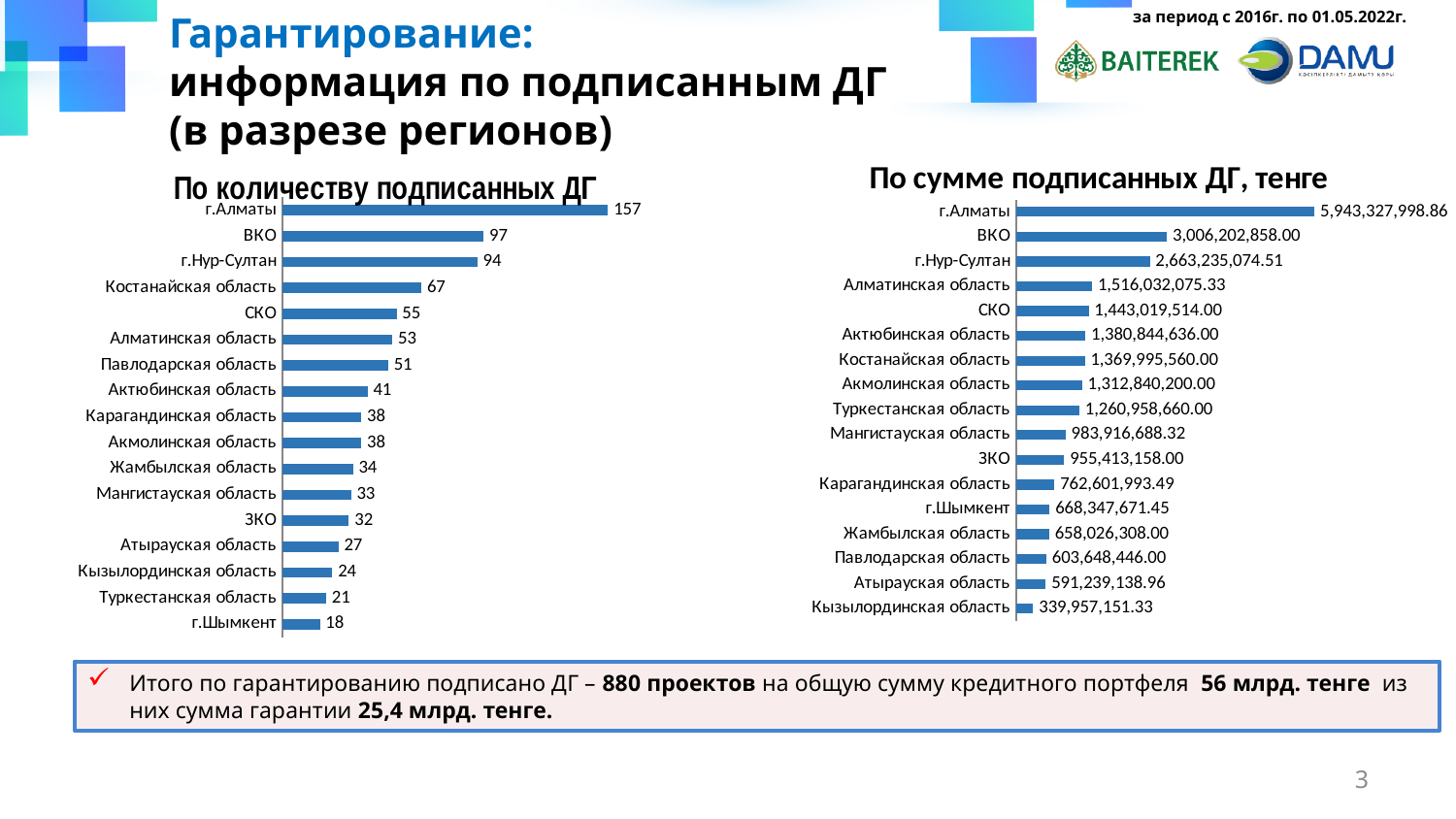
In the chart 'По количеству подписанных ДГ', what is the value for г.Алматы? 157 In the chart 'По количеству подписанных ДГ', which category has the lowest value? г.Шымкент In the chart 'По сумме подписанных ДГ, тенге', what is the value for г.Шымкент? 668,347,671.45 In the chart 'По сумме подписанных ДГ, тенге', what is the value for ВКО? 3,006,202,858.00 What type of chart is 'По сумме подписанных ДГ, тенге'? Bar chart In the chart 'По сумме подписанных ДГ, тенге', what is the value for Кызылординская область? 339,957,151.33 In the chart 'По количеству подписанных ДГ', what is the value for Костанайская область? 67 In the chart 'По количеству подписанных ДГ', which is larger: the value for СКО or the value for Павлодарская область? СКО In the chart 'По количеству подписанных ДГ', what is the difference between the values for ВКО and г.Нур-Султан? 3 In the chart 'По количеству подписанных ДГ', how many categories are shown? 17 In the chart 'По сумме подписанных ДГ, тенге', which is larger: the value for Туркестанская область or the value for Мангистауская область? Туркестанская область In the chart 'По сумме подписанных ДГ, тенге', which category has the highest value? г.Алматы